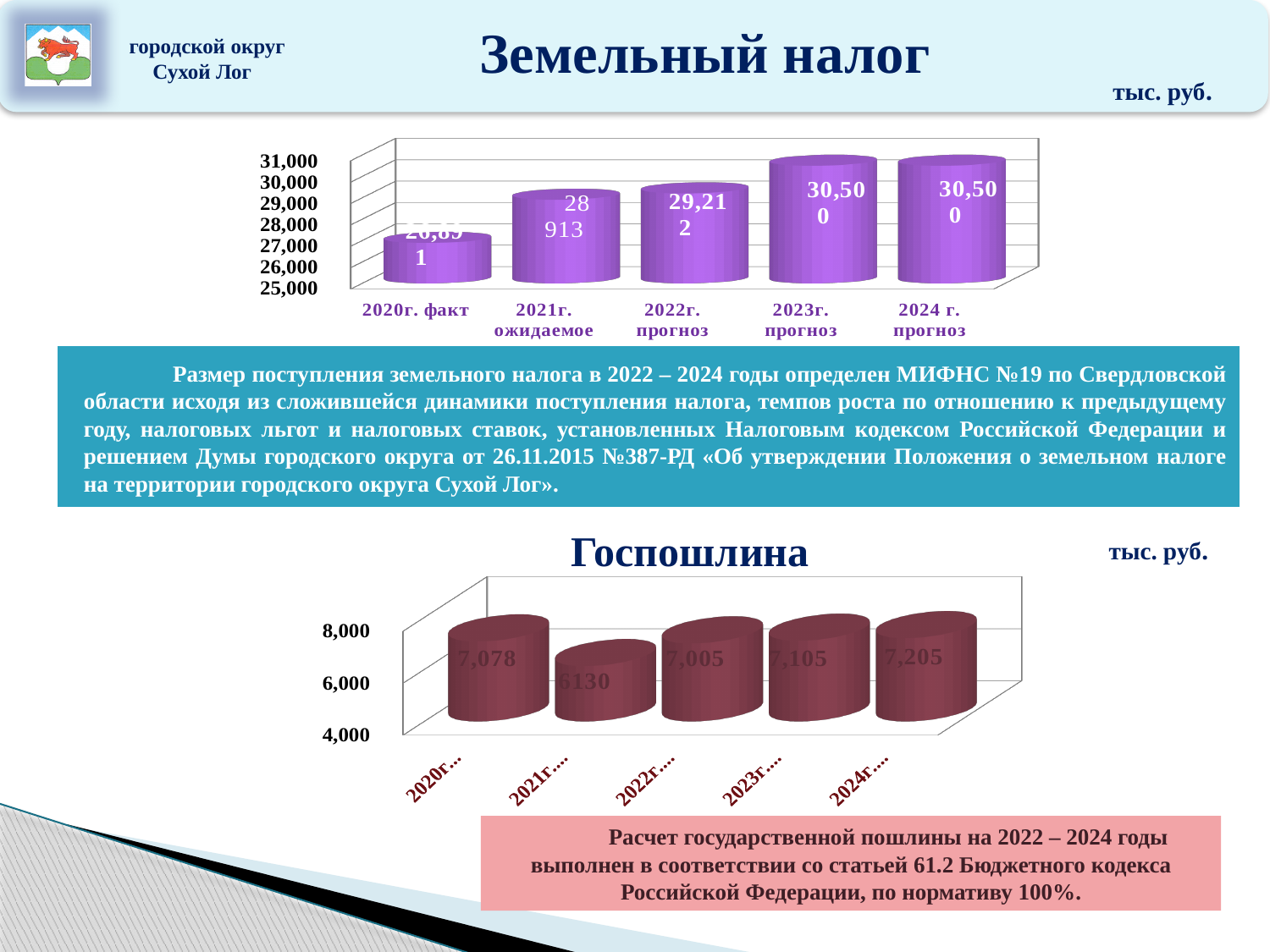
In the Земельный налог chart, do the values generally rise or fall from 2020 to 2024? rise In the Земельный налог chart, what is the difference between the values for 2023г. прогноз and 2022г. прогноз? 1,288 In the Госпошлина chart, what is the value for 2024г.? 7,205 What kind of chart is the Земельный налог chart at the top of the slide? bar chart In the Госпошлина chart, which year has the lowest value? 2021г. In the Земельный налог chart, what is the value for 2023г. прогноз? 30,500 In the Земельный налог chart, what is the value for 2022г. прогноз? 29,212 In the Земельный налог chart, which is larger: the value for 2022г. прогноз or 2021г. ожидаемое? 2022г. прогноз In the Земельный налог chart, what is the value for 2021г. ожидаемое? 28 913 How many categories are shown in the Земельный налог chart? 5 In the Госпошлина chart, what is the difference between the values for 2024г. and 2023г.? 100 In the Земельный налог chart, which category has the lowest value? 2020г. факт